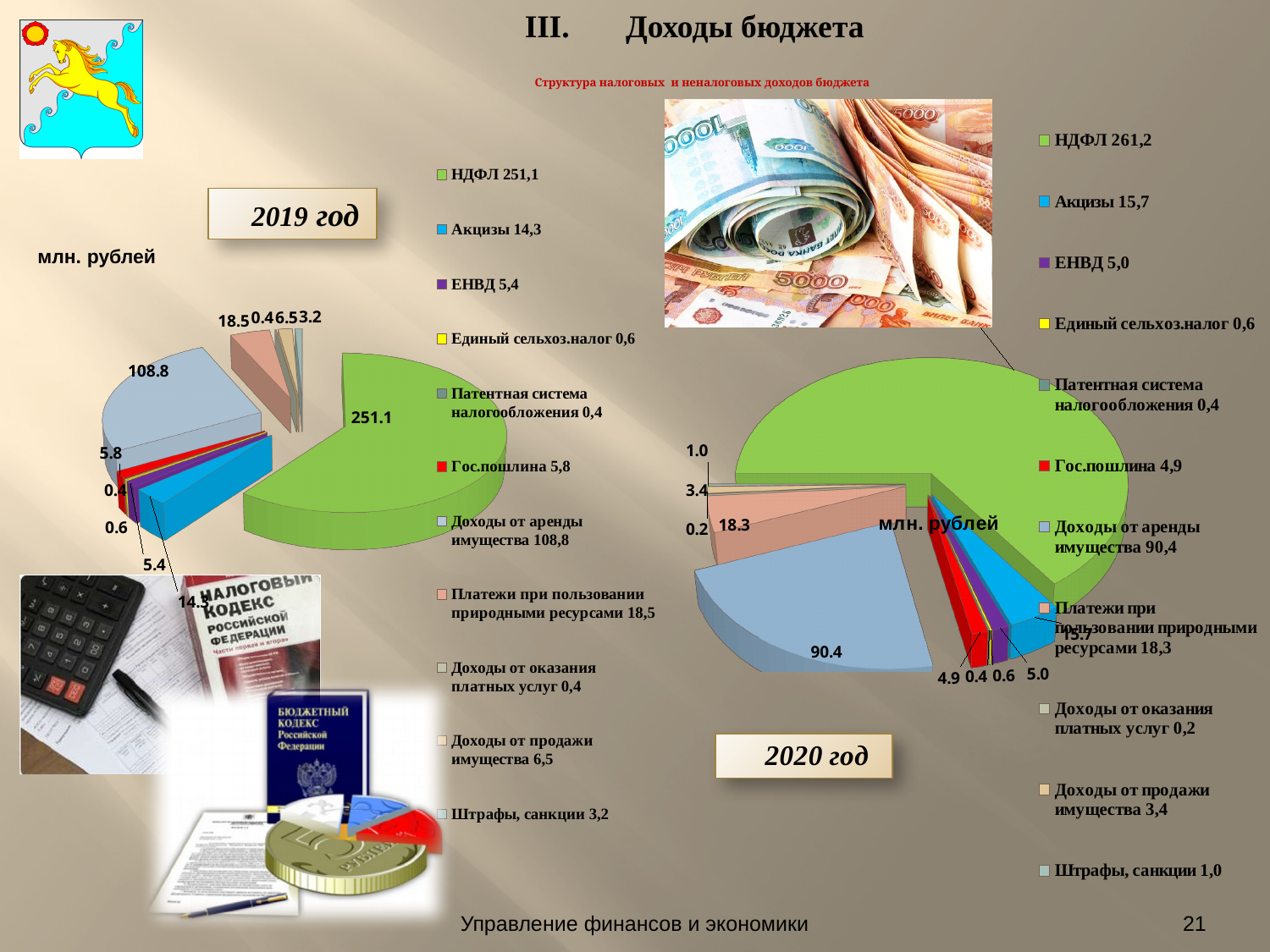
In the 2020 год chart, what is the value for Акцизы? 15,7 What kind of chart is used for the 2019 год data on the left? Pie chart In the 2019 год chart, what is the value for НДФЛ? 251,1 In the 2020 год chart, which category has the largest value? НДФЛ In the 2019 год chart, what is the difference between Доходы от аренды имущества and Платежи при пользовании природными ресурсами? 90,3 In the 2019 год chart, what is the value for Платежи при пользовании природными ресурсами? 18,5 By how much is НДФЛ in the 2020 год chart larger than НДФЛ in the 2019 год chart? 10,1 How many categories does the legend of the 2019 год chart list? 11 Is Доходы от аренды имущества larger in the 2019 год chart or in the 2020 год chart? 2019 год In the 2020 год chart, which category has the smallest value? Доходы от оказания платных услуг In the 2019 год chart, what colour is the НДФЛ slice? Green In the 2020 год chart, what is the value for Доходы от аренды имущества? 90,4